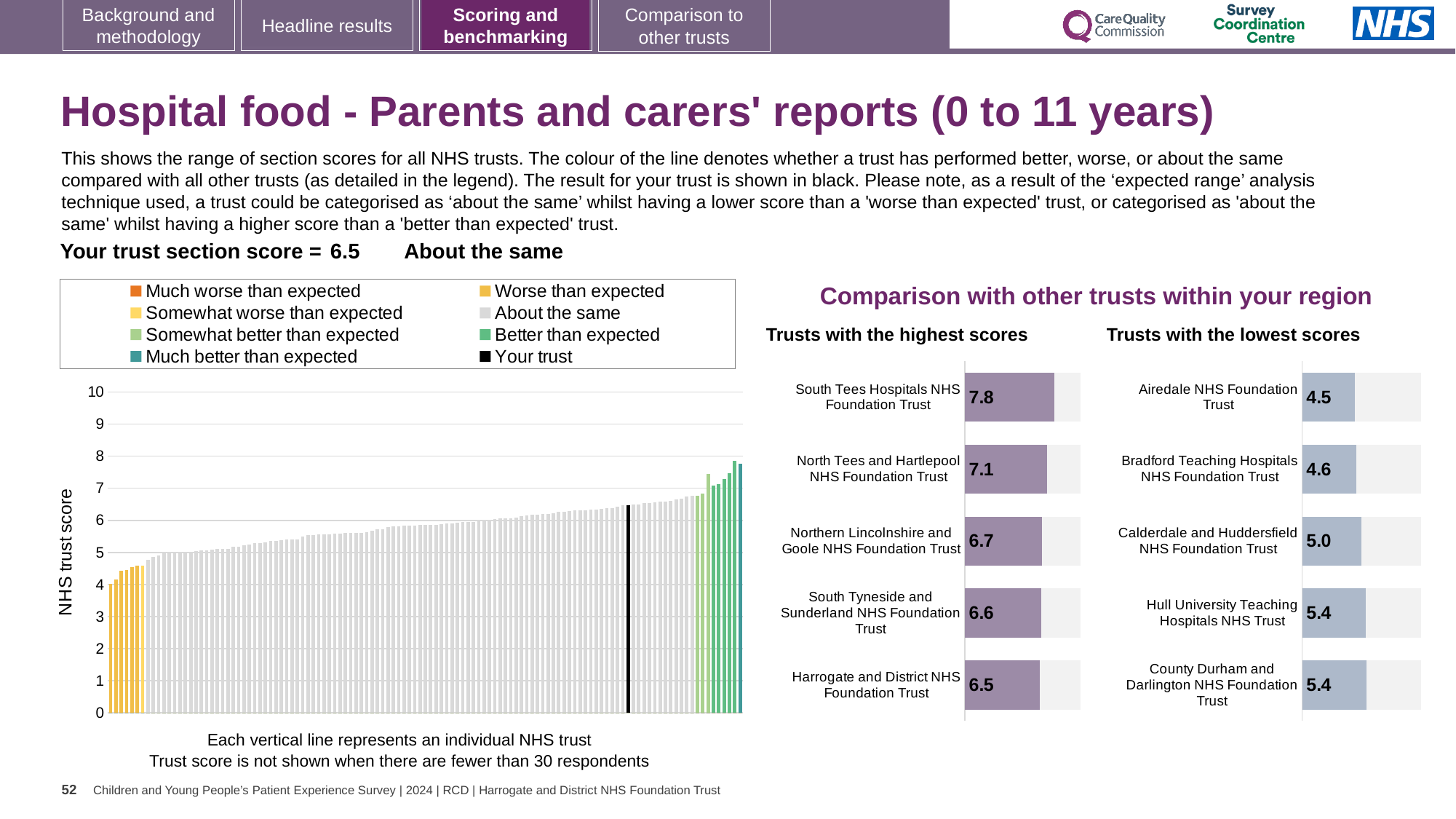
In the 'Trusts with the lowest scores' chart, which has the larger score: Bradford Teaching Hospitals NHS Foundation Trust or Calderdale and Huddersfield NHS Foundation Trust? Calderdale and Huddersfield NHS Foundation Trust How many entries does the legend of the main 'NHS trust score' chart list? 8 In the 'Trusts with the highest scores' chart, which trust has the highest score? South Tees Hospitals NHS Foundation Trust In the 'Trusts with the lowest scores' chart, what is the score for Airedale NHS Foundation Trust? 4.5 In the 'Trusts with the highest scores' chart, what is the difference between the scores of South Tees Hospitals NHS Foundation Trust and Harrogate and District NHS Foundation Trust? 1.3 In the 'Trusts with the lowest scores' chart, what is the score for Calderdale and Huddersfield NHS Foundation Trust? 5.0 In the 'Trusts with the highest scores' chart, what is the score for South Tees Hospitals NHS Foundation Trust? 7.8 In the main 'NHS trust score' chart, do the bar values rise or fall from left to right? rise In the 'Trusts with the lowest scores' chart, which trust has the lowest score? Airedale NHS Foundation Trust In the 'Trusts with the highest scores' chart, what is the score for Northern Lincolnshire and Goole NHS Foundation Trust? 6.7 What kind of chart is the main 'NHS trust score' chart on the left of the slide? bar chart How many trusts are shown in the 'Trusts with the lowest scores' chart? 5